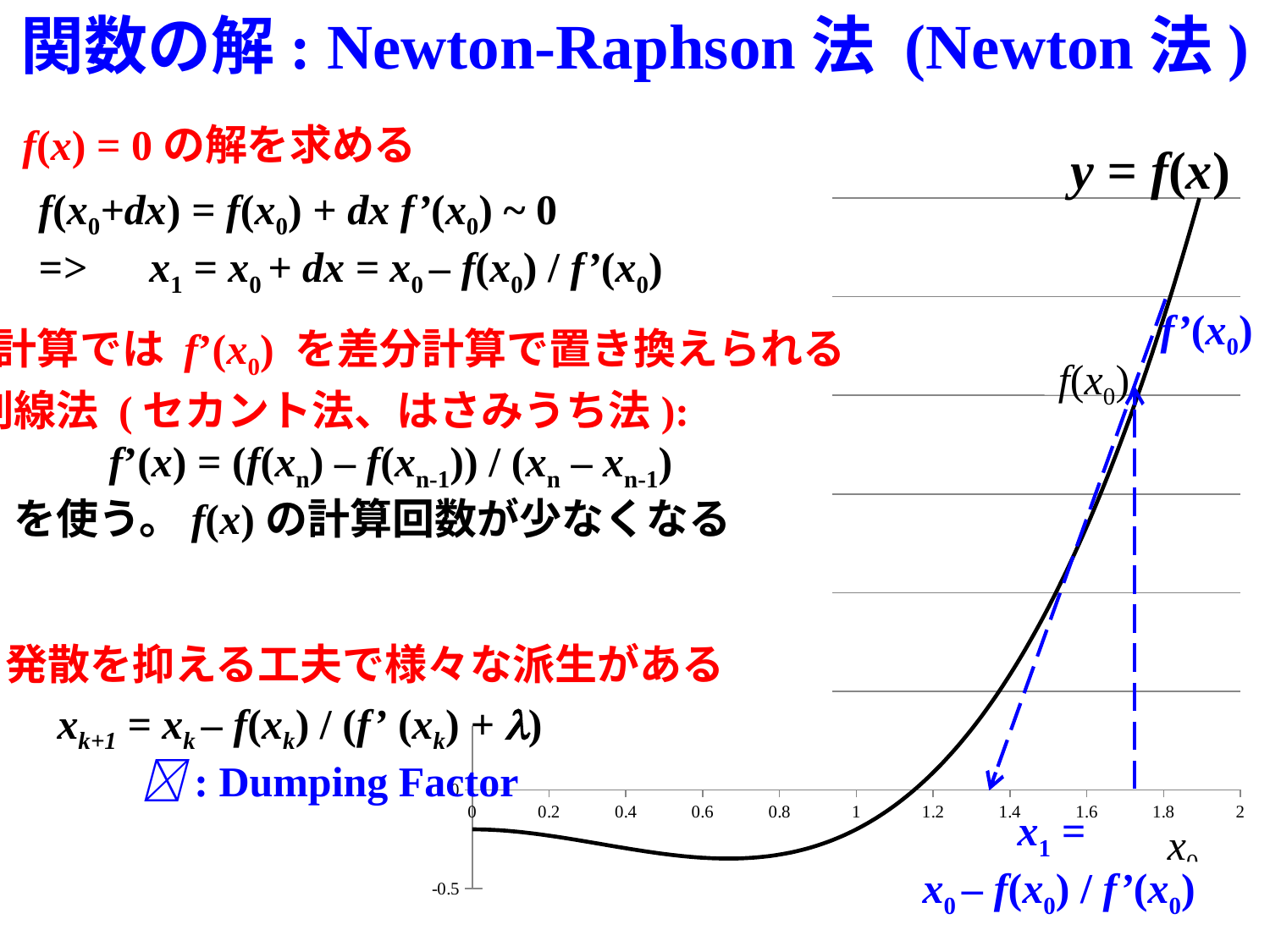
Is the value of the curve at x = 0.6 greater or less than 0? less Is the value of the curve at x = 1.6 greater or less than 0? greater What label is given to the plotted curve on the chart? y = f(x) How many curves are plotted on the chart? 1 What is the spacing between consecutive labelled ticks on the x axis? 0.2 Does the curve rise or fall as x increases from 1.2 to 2? rise What is the lowest value labelled on the y axis of the chart? -0.5 Which is larger, the value of the curve at x = 0.8 or at x = 1.8? x = 1.8 Does the curve rise or fall as x increases from 0 to 0.6? fall What is the largest value labelled on the x axis of the chart? 2 What kind of chart is shown on the slide? line chart